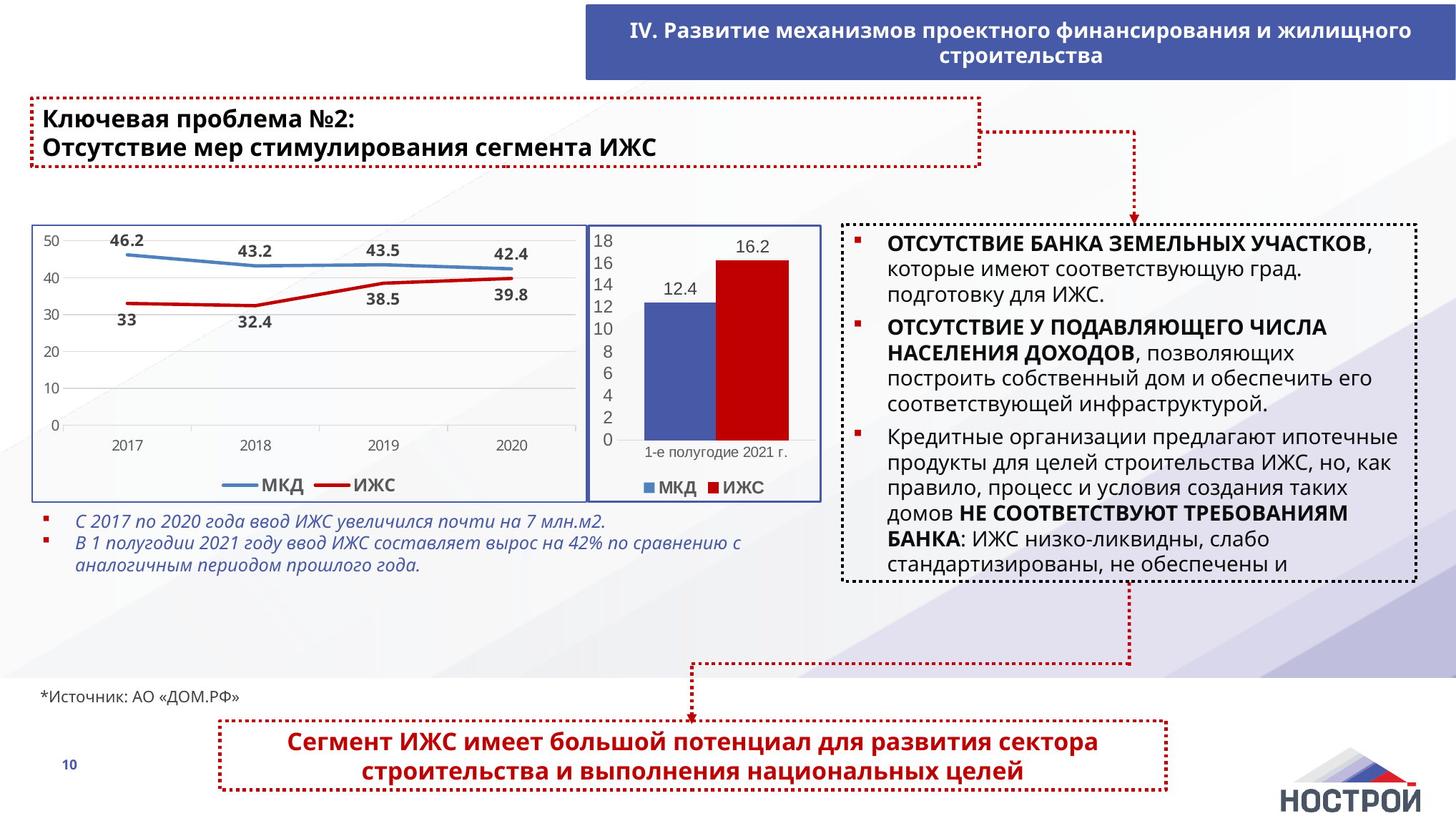
In the right bar chart, which is larger, МКД or ИЖС? ИЖС In the left line chart, in which year is the ИЖС value highest? 2020 In the left line chart, what is the value for ИЖС in 2018? 32.4 In the right bar chart, what is the difference between ИЖС and МКД? 3.8 In the left line chart, does the ИЖС series rise or fall from 2018 to 2020? rise In the right bar chart, what is the value for ИЖС in 1-е полугодие 2021 г.? 16.2 In the left line chart, what is the difference between МКД and ИЖС in 2017? 13.2 In the left line chart, what is the value for МКД in 2017? 46.2 In the left line chart, what is the value for ИЖС in 2020? 39.8 What type of chart is the right chart? bar chart In the left line chart, how many years are shown on the x axis? 4 In the left line chart, in which year is the МКД value lowest? 2020